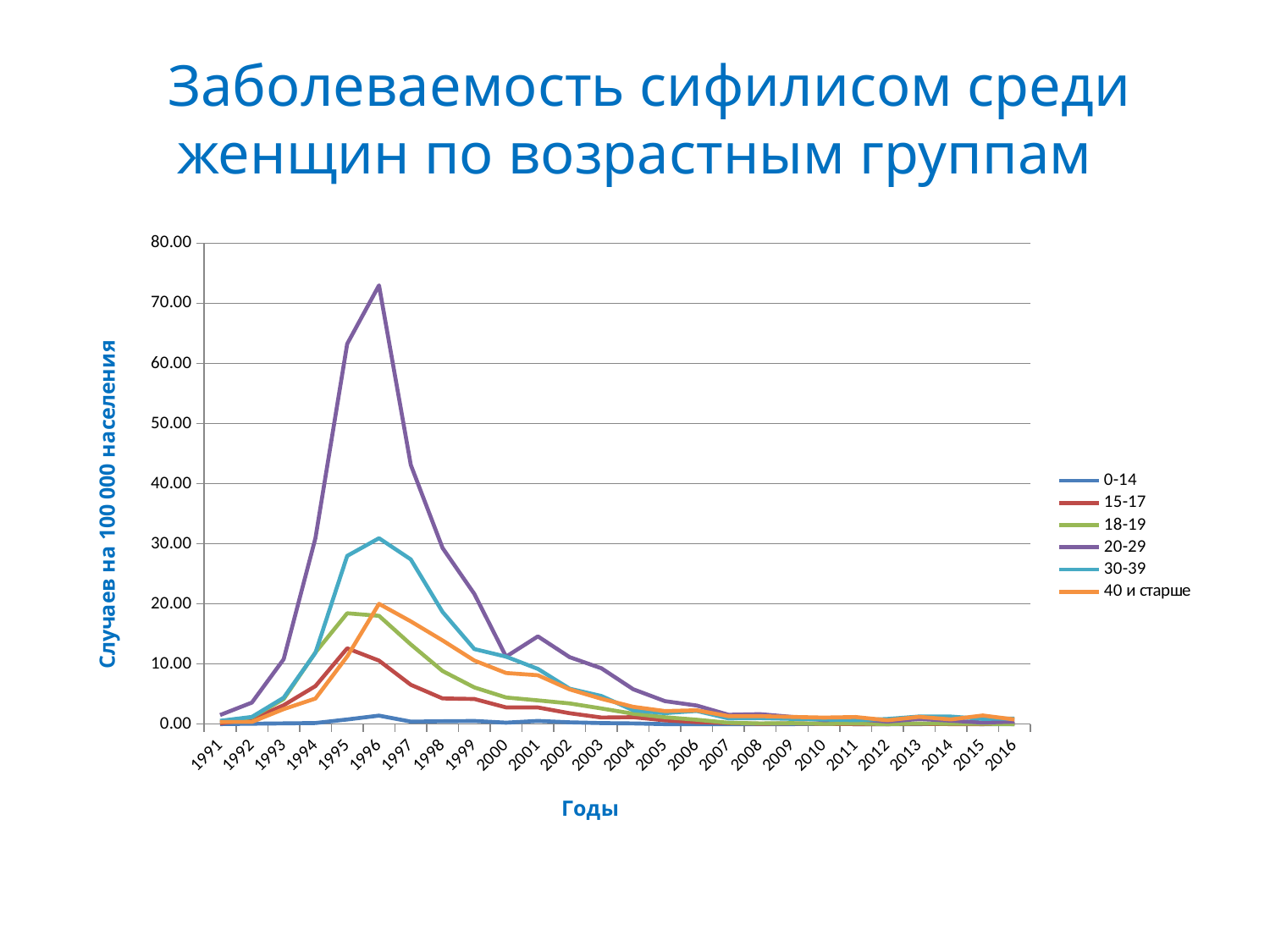
Is the value for the 20-29 group in 2001 greater or less than 10? greater How many years are plotted along the x axis? 26 Which is larger in 1995: the value for 18-19 or the value for 15-17? 18-19 Is the value for the 30-39 group in 1996 greater or less than 20? greater Which age group reaches the highest value on the chart? 20-29 How many series does the legend list? 6 In which year does the 20-29 series reach its peak? 1996 Which age group has the lowest values across the whole period? 0-14 What is the label of the x axis? Годы What kind of chart is shown on the slide? line chart Does the 20-29 series rise or fall from 1996 to 2000? fall Is the value for the 20-29 group in 1996 greater or less than 70? greater